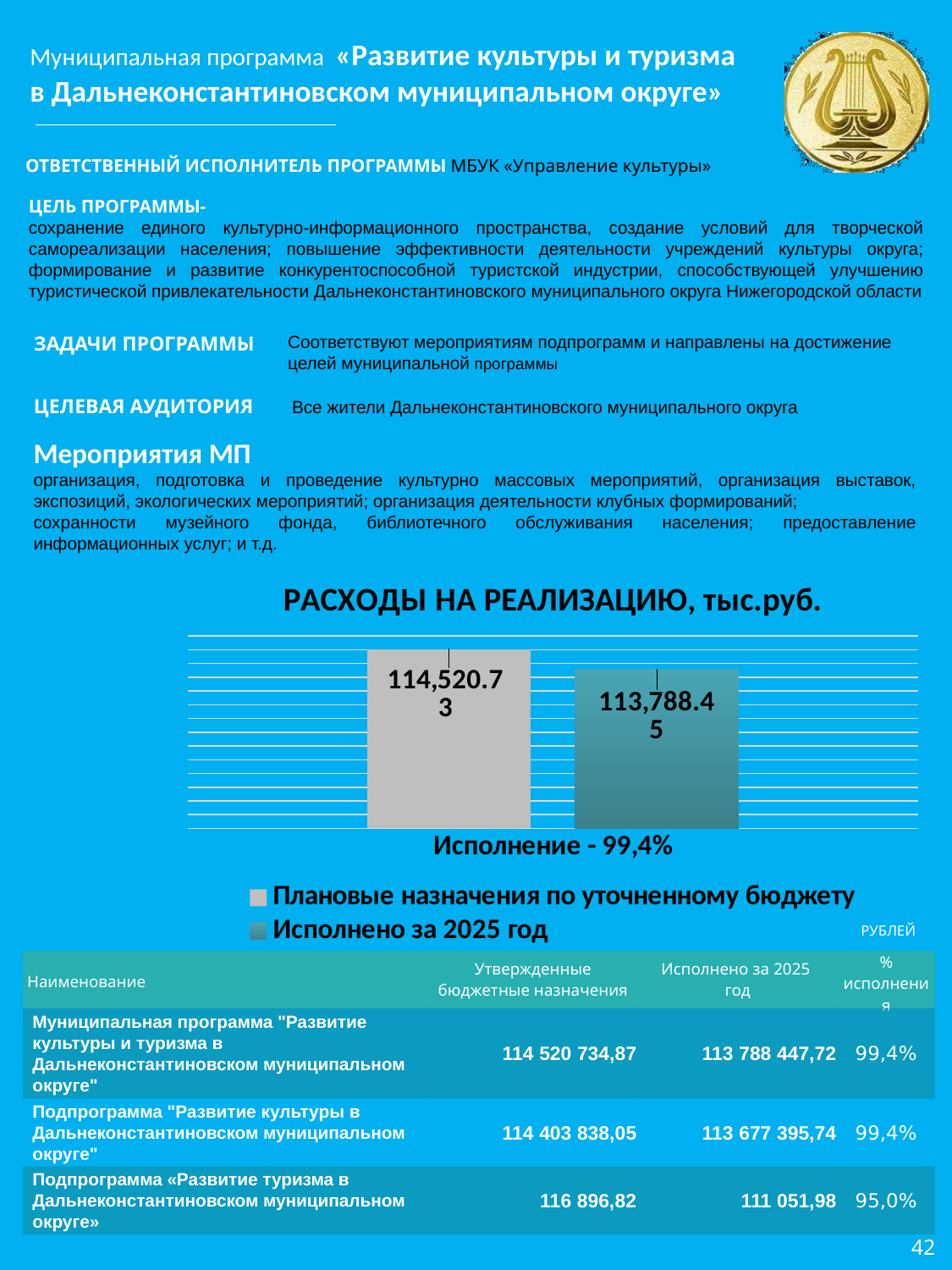
What is the title of the chart? РАСХОДЫ НА РЕАЛИЗАЦИЮ, тыс.руб. What label appears below the bars on the chart's category axis? Исполнение - 99,4% Which series has the lower value in the chart? Исполнено за 2025 год What is the value of the 'Исполнено за 2025 год' bar in the chart? 113,788.45 What is the value of the 'Плановые назначения по уточненному бюджету' bar in the chart? 114,520.73 How many series does the chart legend list? 2 What type of chart is shown on the slide? bar chart What is the difference between the planned value (114,520.73) and the executed value (113,788.45) in the chart? 732.28 Is the value for 'Исполнено за 2025 год' larger or smaller than the value for 'Плановые назначения по уточненному бюджету'? smaller How many bars are plotted in the chart? 2 Which series has the higher value in the chart? Плановые назначения по уточненному бюджету